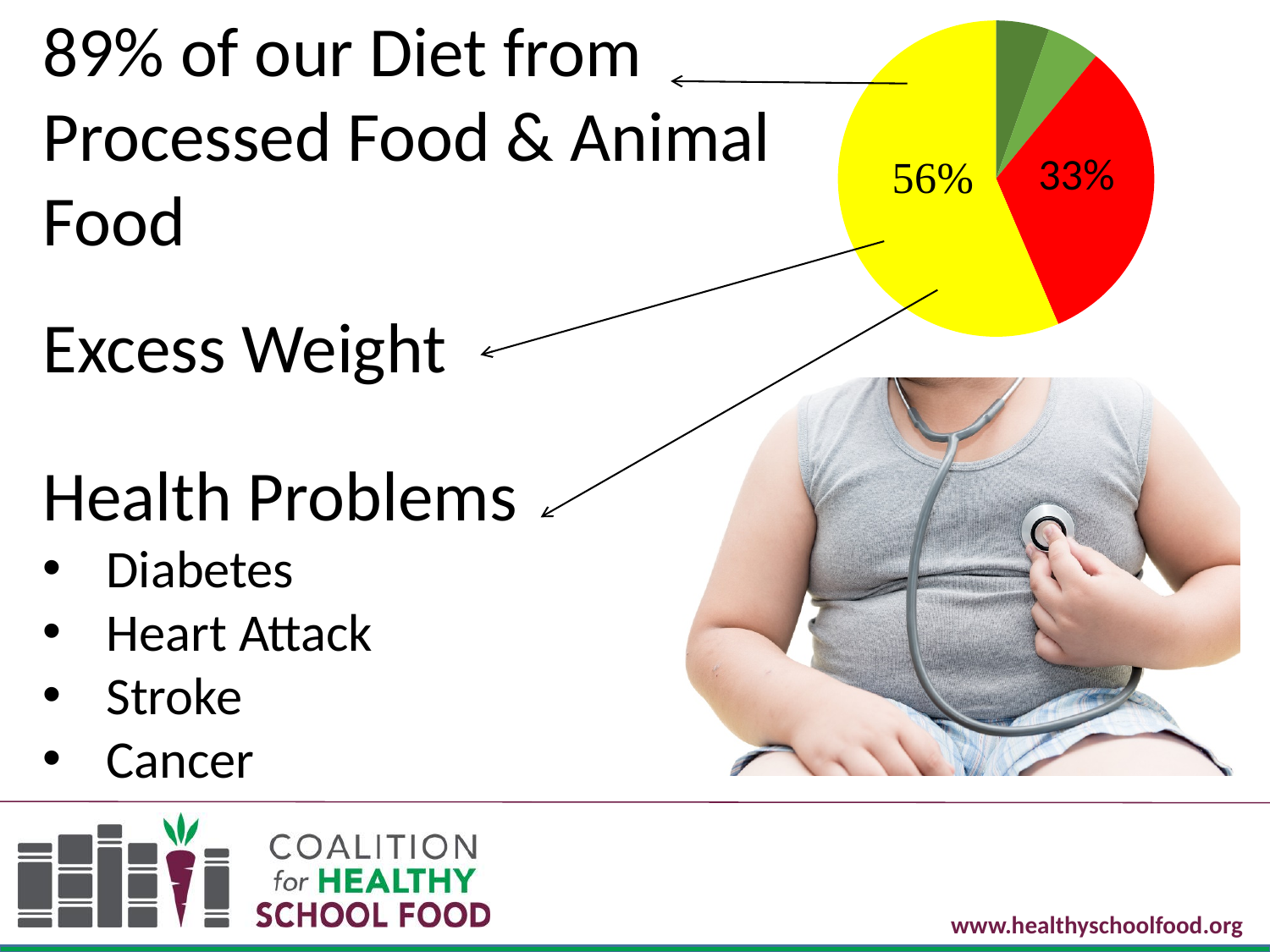
What is the difference between the yellow slice (56%) and the red slice (33%) in the pie chart? 23 percentage points What colours are the two unlabelled slices of the pie chart? dark green and light green What value is labelled on the red slice of the pie chart? 33% Which slice of the pie chart is the largest? the yellow slice (56%) What kind of chart is shown on the slide? pie chart How many slices of the pie chart have no data label? 2 Which is larger in the pie chart, the yellow slice or the red slice? the yellow slice Is the value of the yellow slice in the pie chart greater or less than 50%? greater What share of the pie does the red slice represent? 33% What do the two labelled slices of the pie chart (56% and 33%) add up to? 89% What value is labelled on the yellow slice of the pie chart? 56% How many slices does the pie chart have? 4